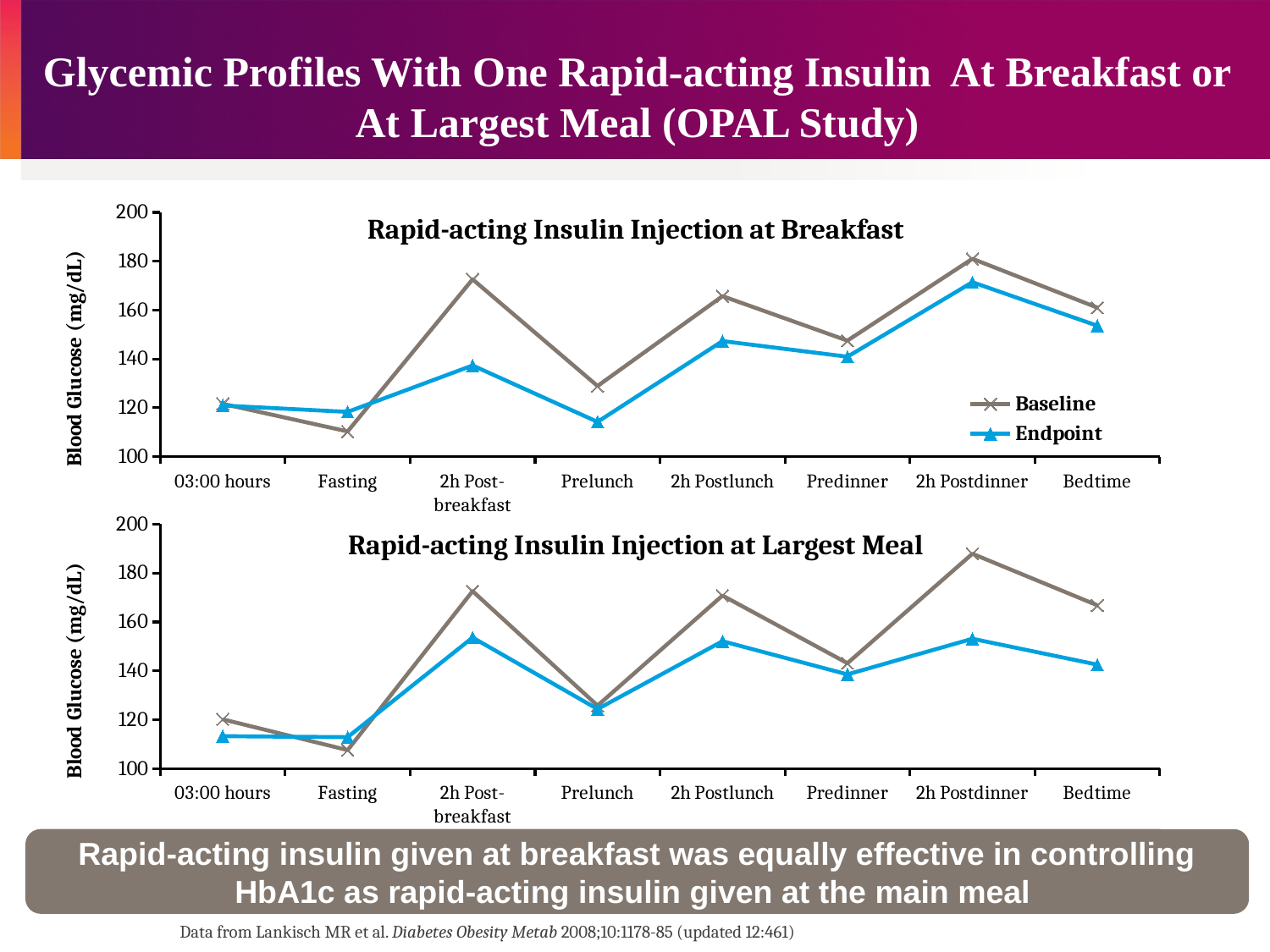
What are the two series named in the legend of the top chart? Baseline and Endpoint In the bottom chart, 'Rapid-acting Insulin Injection at Largest Meal', at which time point is the Baseline blood glucose highest? 2h Postdinner In the top chart, 'Rapid-acting Insulin Injection at Breakfast', is the Baseline value at 2h Post-breakfast greater or less than 160? greater In the top chart, 'Rapid-acting Insulin Injection at Breakfast', at which time point is the Baseline blood glucose highest? 2h Postdinner In the top chart, 'Rapid-acting Insulin Injection at Breakfast', at which time point is the Baseline blood glucose lowest? Fasting How many series does the legend of the top chart list? 2 In the bottom chart, 'Rapid-acting Insulin Injection at Largest Meal', does the Baseline line rise or fall from Predinner to 2h Postdinner? rise In the top chart, 'Rapid-acting Insulin Injection at Breakfast', which series has the larger value at 2h Post-breakfast, Baseline or Endpoint? Baseline In the top chart, 'Rapid-acting Insulin Injection at Breakfast', is the Endpoint value at Prelunch greater or less than 120? less In the bottom chart, 'Rapid-acting Insulin Injection at Largest Meal', is the Baseline value at 2h Postdinner greater or less than 180? greater How many time points are shown along the x axis of the bottom chart, 'Rapid-acting Insulin Injection at Largest Meal'? 8 What kind of chart is the top chart, 'Rapid-acting Insulin Injection at Breakfast'? Line chart